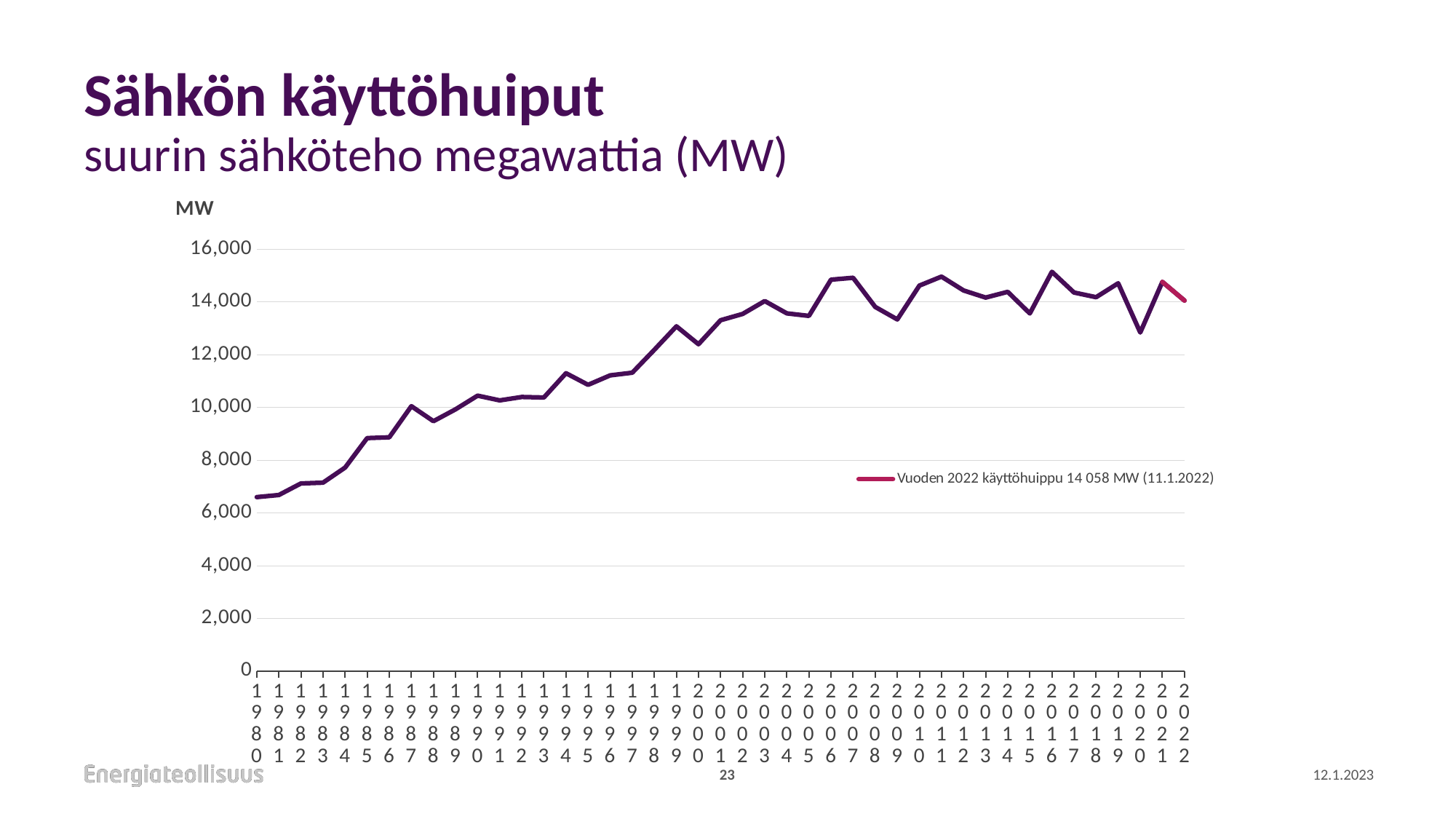
According to the legend, what was the peak electricity usage in 2022? 14 058 MW What is the title of the chart on the slide? Sähkön käyttöhuiput Which year has the larger value, 2019 or 2020? 2019 What kind of chart is shown on the slide? line chart Which year has the highest peak usage in the chart? 2016 Do the values generally rise or fall from 1980 to 2022? rise Is the value for 2000 greater or less than 12,000? greater Is the value for 1980 greater or less than 8,000? less Is the value for 2020 greater or less than 14,000? less How many years (data points) are plotted on the x axis? 43 What unit is shown on the y axis of the chart? MW